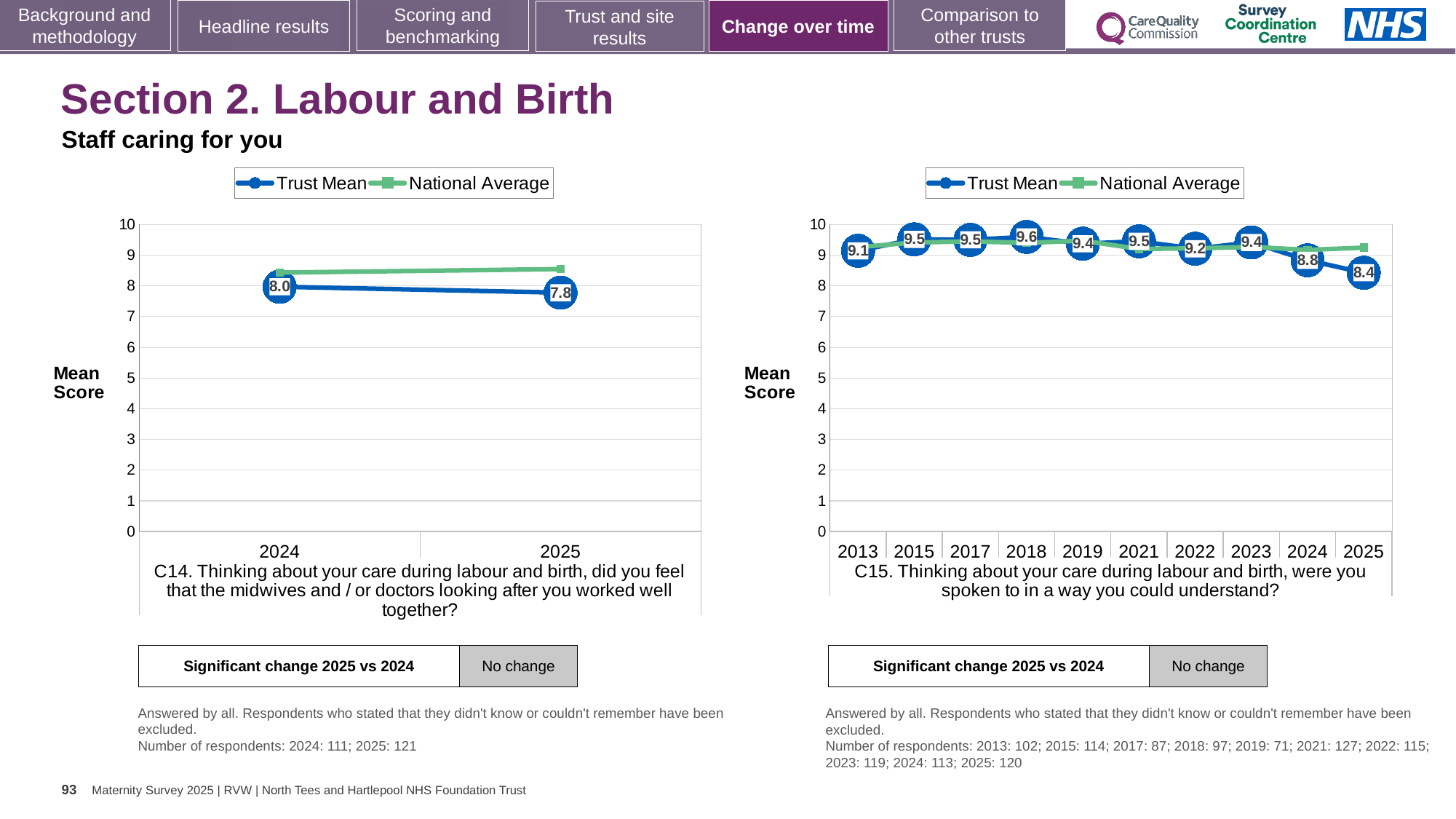
In the right chart (C15), which year has the highest Trust Mean? 2018 How many series does the legend of the left chart list? 2 In the right chart (C15), what is the Trust Mean for 2025? 8.4 In the left chart (C14), does the Trust Mean rise or fall from 2024 to 2025? fall In the left chart (C14), what is the difference between the Trust Mean for 2024 and 2025? 0.2 In the left chart (C14), is the National Average for 2025 greater or less than 8? greater In the left chart (C14), what is the Trust Mean for 2024? 8.0 In the right chart (C15), which year has the lowest Trust Mean? 2025 In the right chart (C15), which is larger, the Trust Mean for 2013 or for 2024? 2013 In the left chart (C14), what is the Trust Mean for 2025? 7.8 In the right chart (C15), how many years are plotted on the x axis? 10 In the right chart (C15), what is the Trust Mean for 2018? 9.6